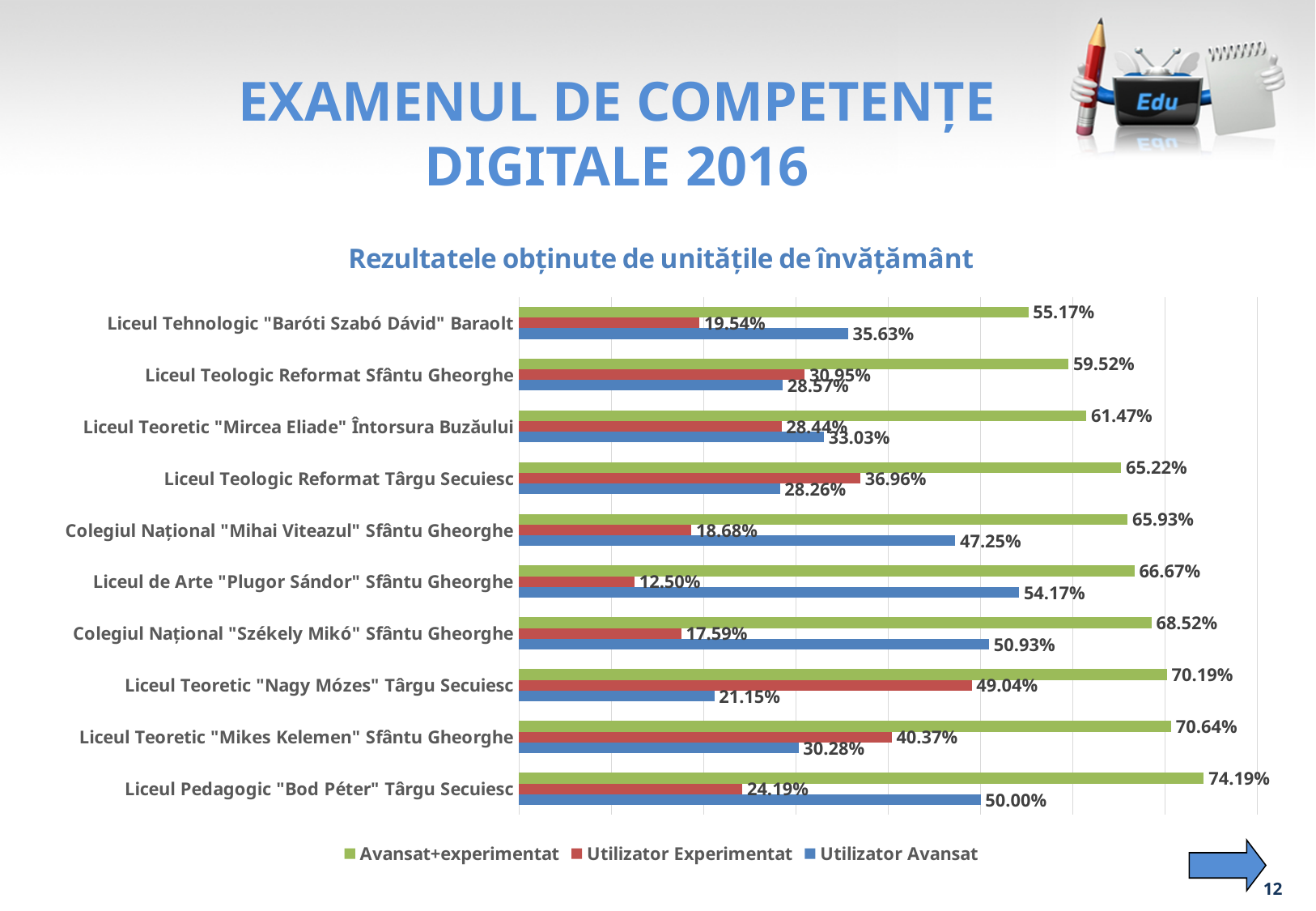
What is the Utilizator Avansat value for Colegiul Național "Mihai Viteazul" Sfântu Gheorghe? 47.25% What is the Utilizator Experimentat value for Liceul Teoretic "Nagy Mózes" Târgu Secuiesc? 49.04% Which is larger for Liceul Teoretic "Mikes Kelemen" Sfântu Gheorghe: Utilizator Experimentat or Utilizator Avansat? Utilizator Experimentat How many schools are shown in the chart? 10 What is the title of the chart? Rezultatele obținute de unitățile de învățământ Which school has the highest Utilizator Avansat value? Liceul de Arte "Plugor Sándor" Sfântu Gheorghe What kind of chart is shown on the slide? Bar chart How many series does the legend list? 3 What is the Avansat+experimentat value for Liceul Pedagogic "Bod Péter" Târgu Secuiesc? 74.19% Which school has the lowest Avansat+experimentat value? Liceul Tehnologic "Baróti Szabó Dávid" Baraolt What is the difference between the Avansat+experimentat and Utilizator Avansat values for Liceul Pedagogic "Bod Péter" Târgu Secuiesc? 24.19 percentage points Which school has the lowest Utilizator Experimentat value? Liceul de Arte "Plugor Sándor" Sfântu Gheorghe